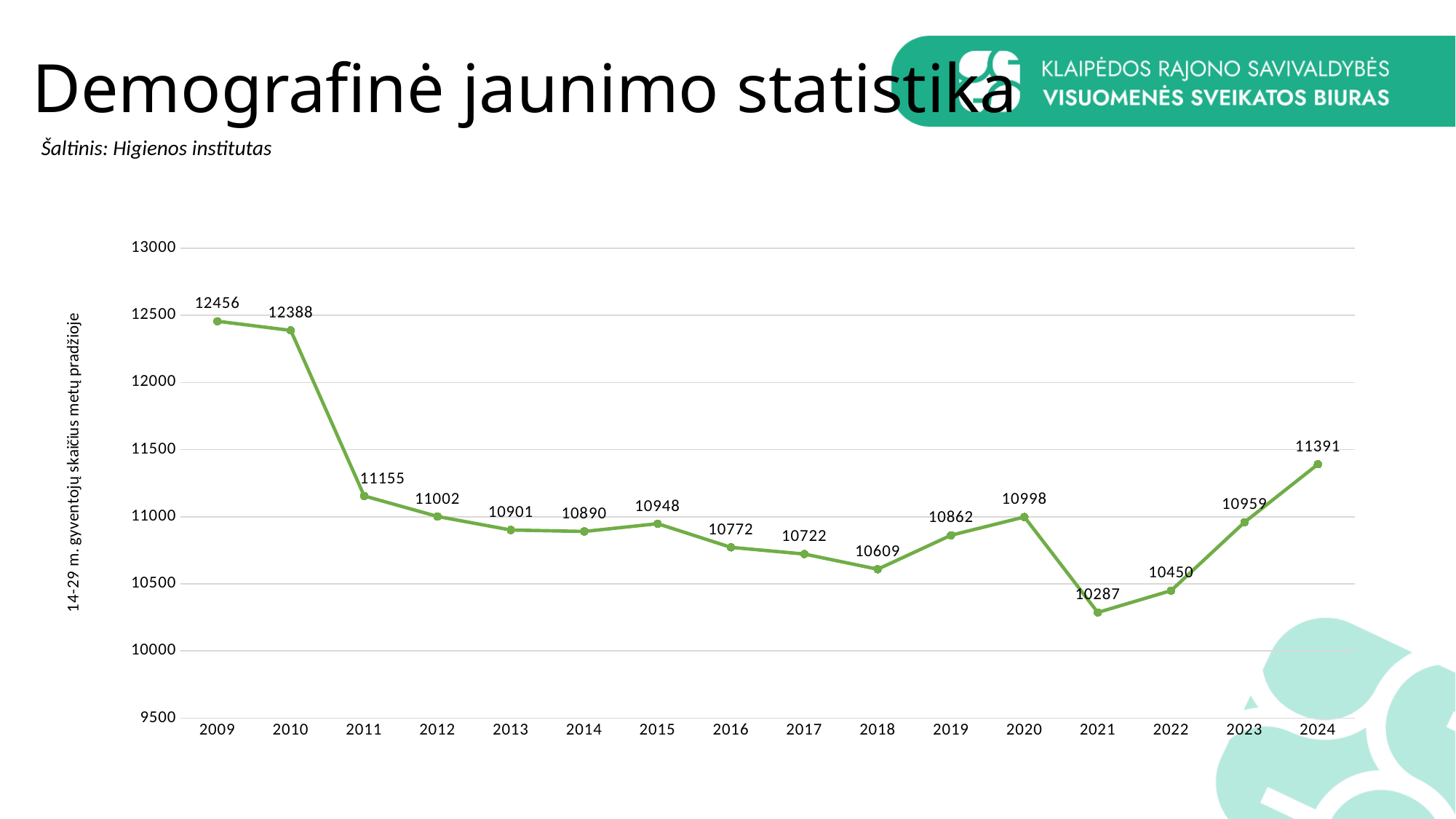
Is the value for 2011 greater or less than 11000? greater What is the difference between the values for 2009 and 2010? 68 How many years are plotted on the chart? 16 Which year has the lowest value? 2021 What is the value for 2009? 12456 What kind of chart is shown on the slide? line chart What is the difference between the values for 2024 and 2021? 1104 What is the value for 2021? 10287 Which is larger, the value for 2015 or the value for 2018? 2015 Do the values rise or fall from 2009 to 2012? fall What is the value for 2024? 11391 Which year has the highest value? 2009